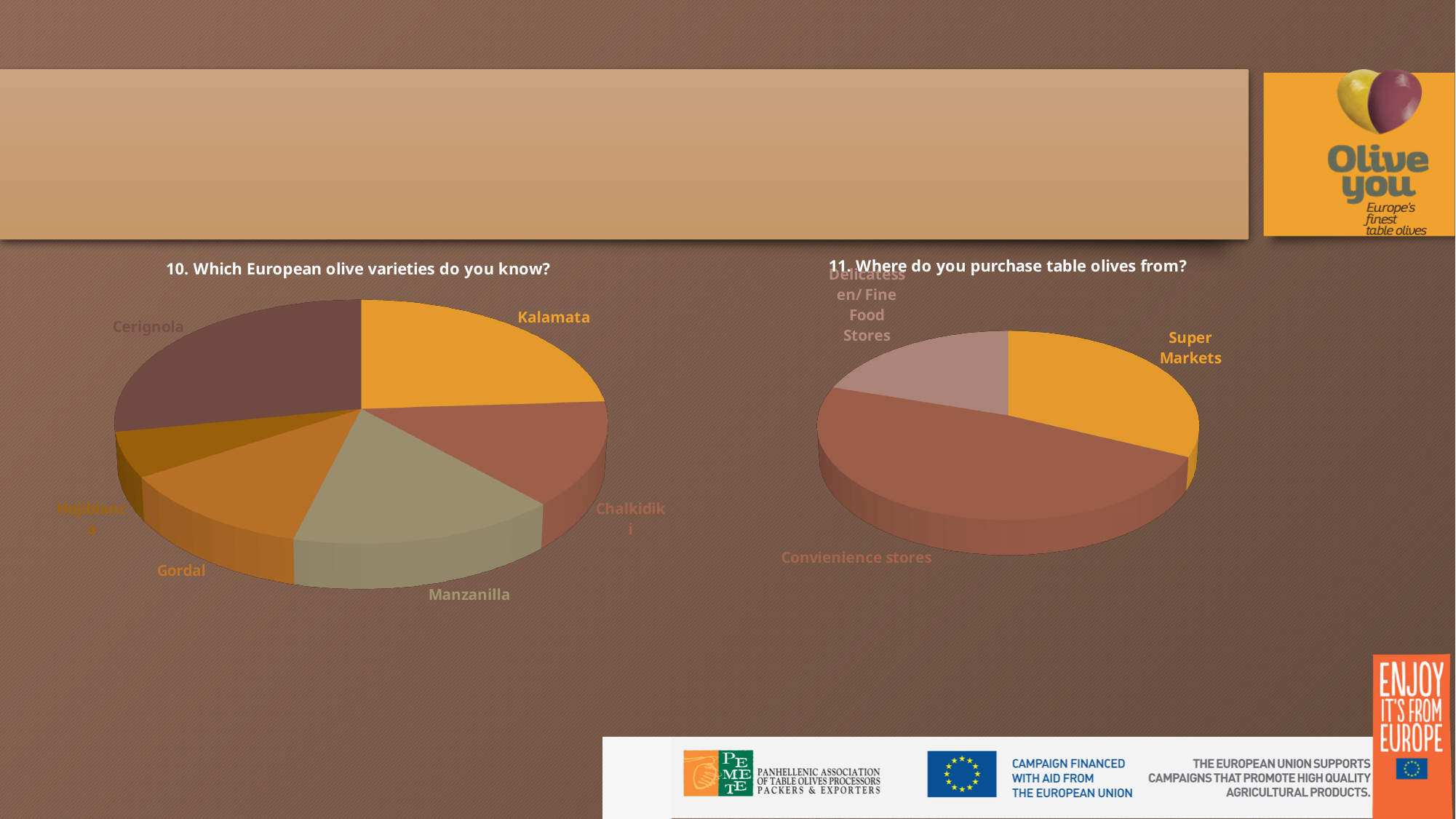
What kind of chart is the chart titled "10. Which European olive varieties do you know?"? pie chart In the chart titled "11. Where do you purchase table olives from?", which purchase location has the smallest slice? Delicatessen/ Fine Food Stores In the chart titled "11. Where do you purchase table olives from?", which slice is larger, Super Markets or Convienience stores? Convienience stores In the chart titled "10. Which European olive varieties do you know?", which olive variety has the smallest slice? Hojiblanca In the chart titled "11. Where do you purchase table olives from?", which purchase location has the largest slice? Convienience stores How many slices does the chart titled "11. Where do you purchase table olives from?" have? 3 In the chart titled "11. Where do you purchase table olives from?", what colour is the Super Markets slice? yellow/orange What is the title of the pie chart on the left side of the slide? 10. Which European olive varieties do you know? What kind of chart is the chart titled "11. Where do you purchase table olives from?"? pie chart How many slices does the chart titled "10. Which European olive varieties do you know?" have? 6 In the chart titled "10. Which European olive varieties do you know?", which slice is larger, Kalamata or Hojiblanca? Kalamata In the chart titled "10. Which European olive varieties do you know?", which slice is larger, Manzanilla or Gordal? Manzanilla